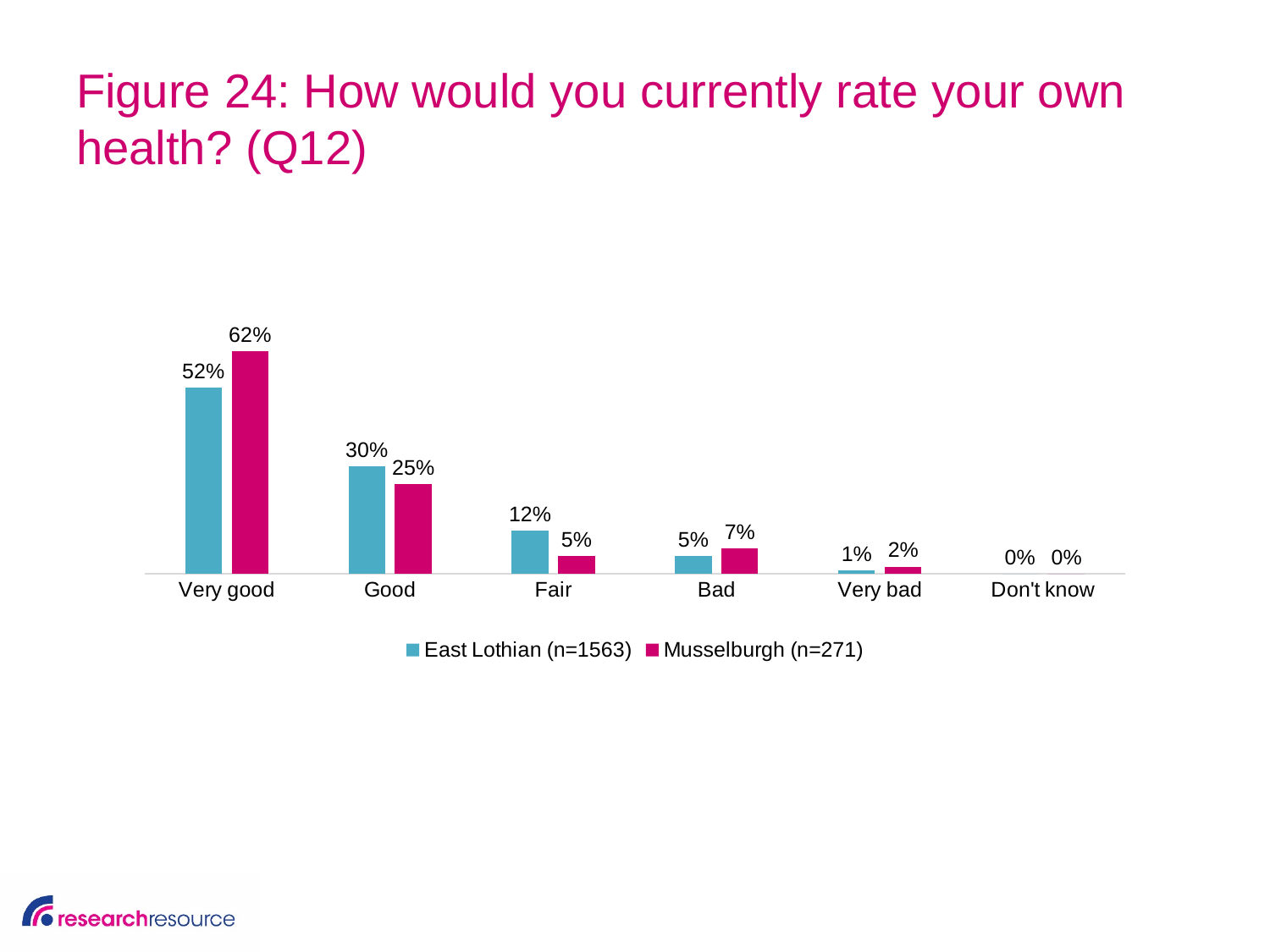
What is the sample size (n) for the Musselburgh series shown in the legend? 271 Which is larger for Bad: East Lothian or Musselburgh? Musselburgh What is the Musselburgh value for Fair? 5% Which category has the highest value for Musselburgh? Very good How many categories are shown on the x axis? 6 What percentage of East Lothian respondents rated their health as Very good? 52% What is the difference between the Musselburgh and East Lothian values for Very good? 10% What percentage of Musselburgh respondents rated their health as Good? 25% Which category has the lowest value for East Lothian? Don't know What kind of chart is shown on the slide? Bar chart What is the difference between the East Lothian and Musselburgh values for Fair? 7% How many series does the legend list? 2